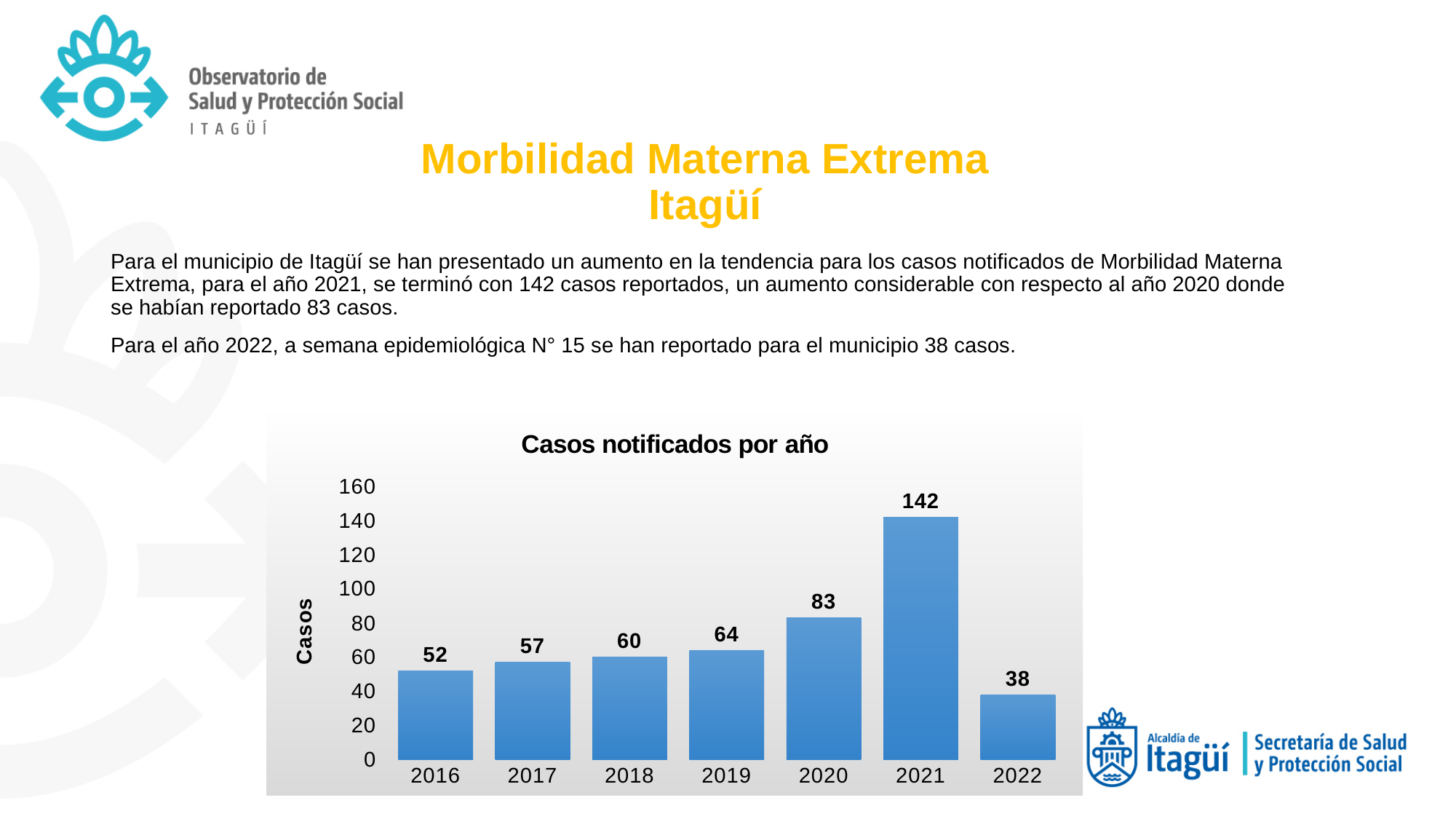
What is the title of the chart? Casos notificados por año Which is larger, the value for 2017 or the value for 2019? 2019 What is the value for 2021 in the chart? 142 How many years are shown on the x axis of the chart? 7 Is the value for 2020 greater or less than 100? less Which year has the highest number of cases? 2021 What kind of chart is shown on the slide? bar chart Which year has the lowest number of cases? 2022 What is the value shown for 2022? 38 How many cases were notified in 2018 according to the chart? 60 What is the difference between the values for 2021 and 2020? 59 What is the difference between the values for 2019 and 2016? 12